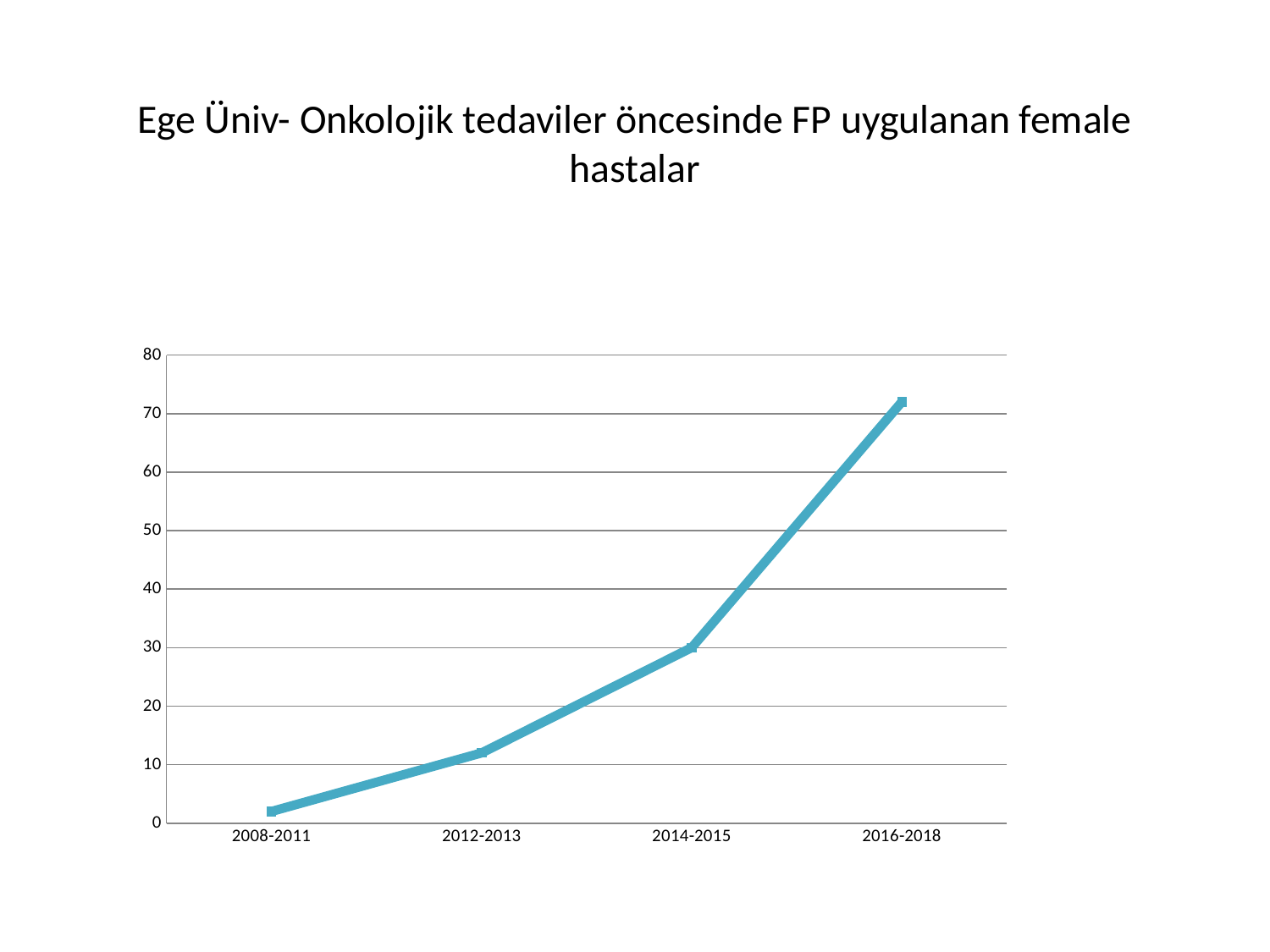
What is the title of the slide? Ege Üniv- Onkolojik tedaviler öncesinde FP uygulanan female hastalar What kind of chart is shown on the slide? line chart How many periods are plotted along the x axis? 4 Is the value for 2012-2013 greater or less than 20? less What is the highest value shown on the y axis? 80 Is the value for 2008-2011 greater or less than 10? less Which period has the highest value? 2016-2018 Which period has the lowest value? 2008-2011 Which is larger, the value for 2014-2015 or the value for 2012-2013? 2014-2015 Do the values rise or fall from 2008-2011 to 2016-2018? rise Is the value for 2014-2015 greater or less than 40? less